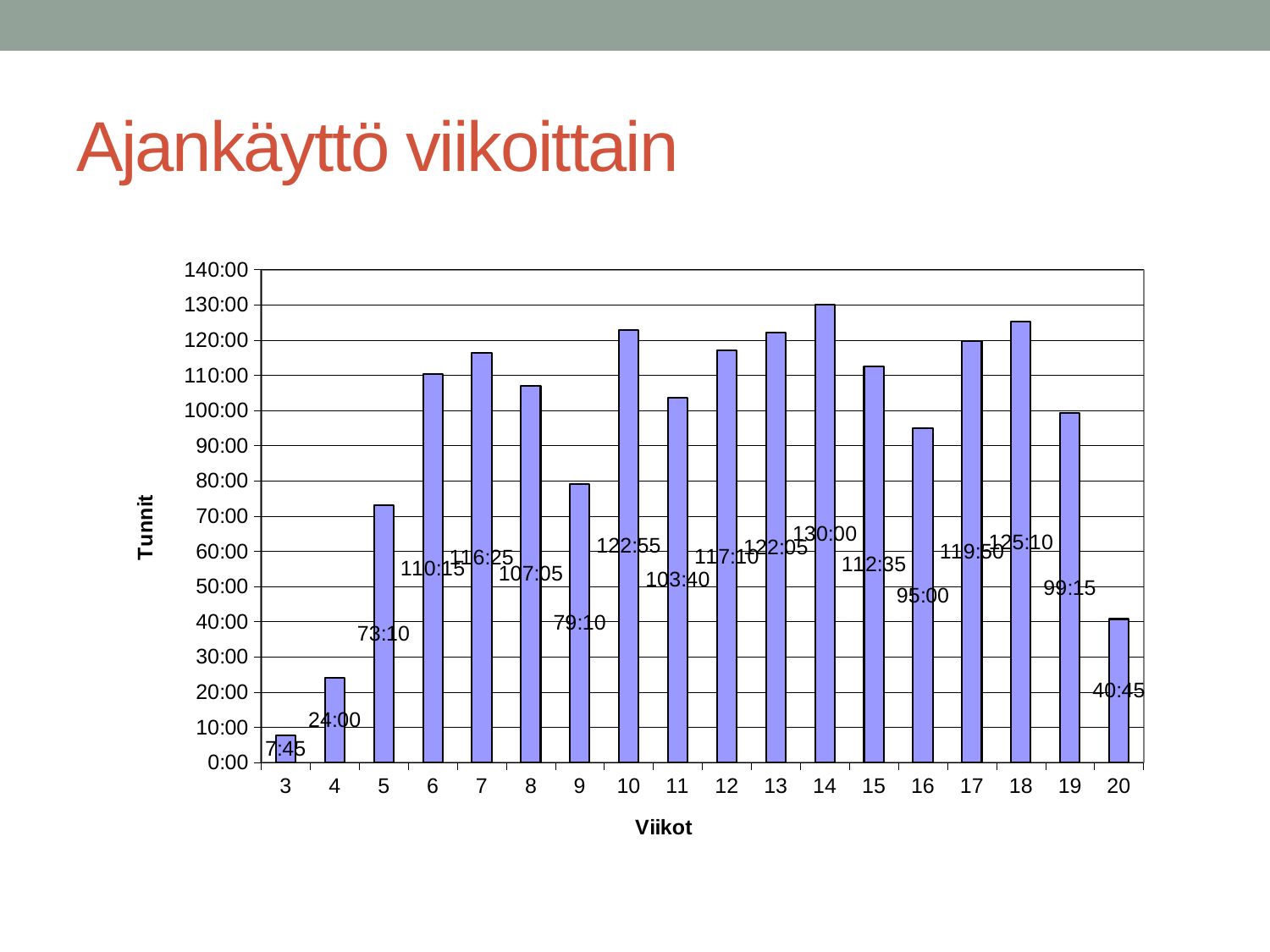
Which week has the lowest value? 3 What is the value for week 3? 7:45 Which has the larger value, week 10 or week 11? week 10 What kind of chart is shown on the slide? bar chart What is the label of the horizontal axis? Viikot What is the label of the vertical axis? Tunnit What is the value for week 14? 130:00 Which week has the highest value? 14 What is the value for week 20? 40:45 How many weeks are shown on the x axis? 18 What is the difference between the values for week 4 and week 3? 16:15 Is the value for week 16 greater or less than 100:00? less